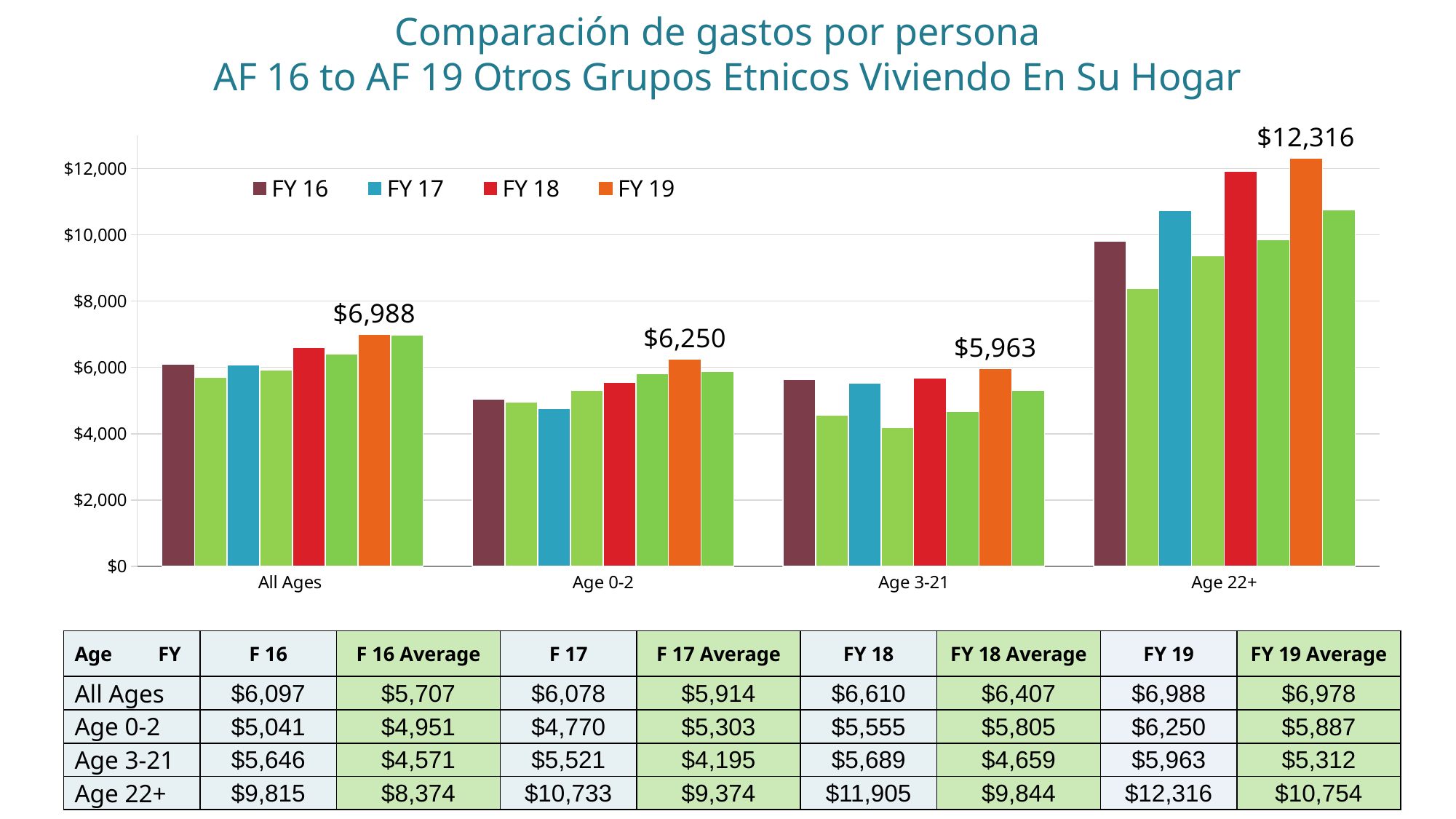
Which age category has the lowest FY 17 value? Age 0-2 How many age categories are shown on the x axis? 4 How many series does the legend list? 4 What is the FY 17 value for Age 3-21? $5,521 What is the FY 19 value for All Ages? $6,988 What is the FY 18 value for Age 0-2? $5,555 Is the FY 18 value for Age 22+ greater or less than $10,000? greater What kind of chart is shown on the slide? Bar chart Which age category has the highest FY 19 value? Age 22+ What is the FY 19 value for Age 22+? $12,316 Which is larger for Age 3-21: the FY 16 value or the FY 18 value? FY 18 What is the difference between the FY 19 and FY 16 values for Age 22+? $2,501